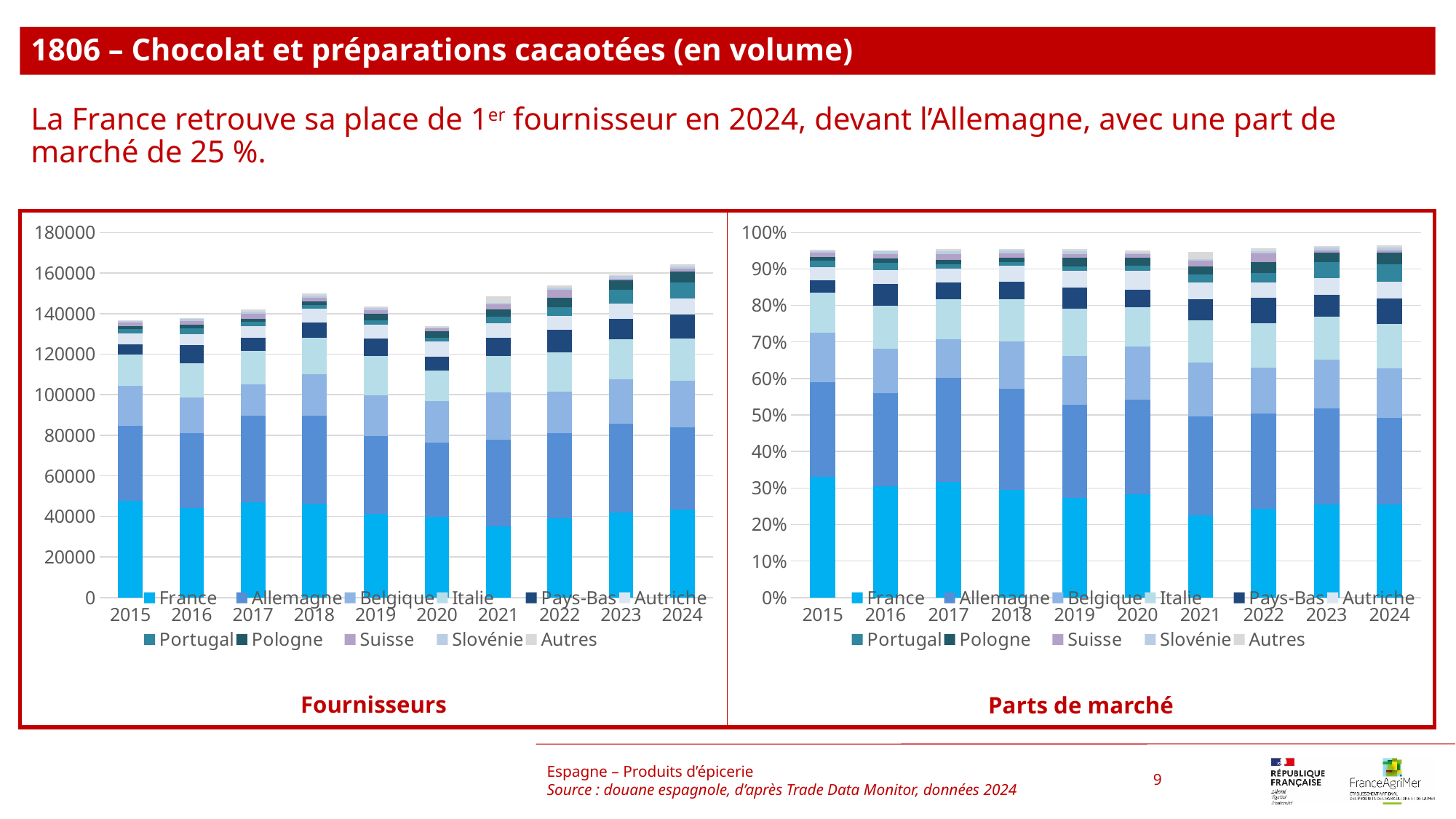
In the 'Fournisseurs' chart, is the total height of the 2020 bar greater or less than 140000? less In the 'Parts de marché' chart, is the share for France in 2021 greater or less than 30%? less In the 'Parts de marché' chart, is the share for France in 2015 greater or less than 30%? greater How many series does the legend of the 'Fournisseurs' chart list? 11 How many years are shown on the x axis of the 'Parts de marché' chart? 10 In the 'Parts de marché' chart, does the share for France rise or fall overall from 2015 to 2024? fall What kind of chart is the 'Fournisseurs' chart on the left? Stacked bar chart In the 'Fournisseurs' chart, which year has the highest total bar? 2024 What is the title of the chart on the right of the slide? Parts de marché In the 'Fournisseurs' chart, is the value for France larger in 2015 or in 2021? 2015